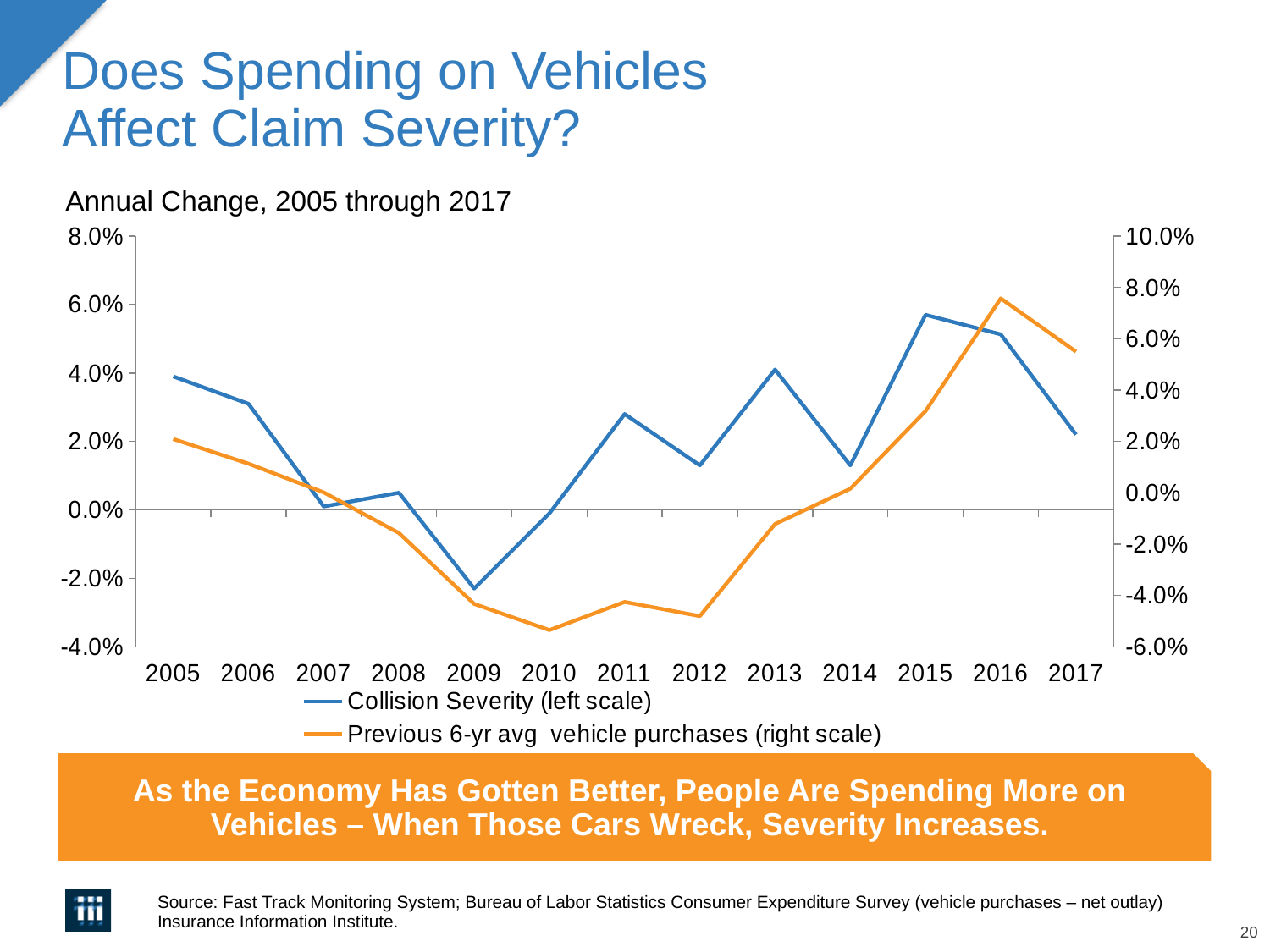
How many years are plotted along the x axis? 13 In which year does the Previous 6-yr avg vehicle purchases (right scale) series reach its lowest value? 2010 Is the Previous 6-yr avg vehicle purchases value for 2010 greater or less than -4.0% on the right scale? less Does the Previous 6-yr avg vehicle purchases series rise or fall from 2012 to 2016? Rise Which series is plotted on the right scale according to the legend? Previous 6-yr avg vehicle purchases Is the Collision Severity value for 2015 greater or less than 4.0% on the left scale? greater In which year does the Collision Severity (left scale) series reach its lowest value? 2009 What kind of chart is shown on the slide? Line chart In which year does the Previous 6-yr avg vehicle purchases (right scale) series reach its highest value? 2016 How many series does the legend list? 2 In which year does the Collision Severity (left scale) series reach its highest value? 2015 Does the Collision Severity series rise or fall from 2015 to 2017? Fall